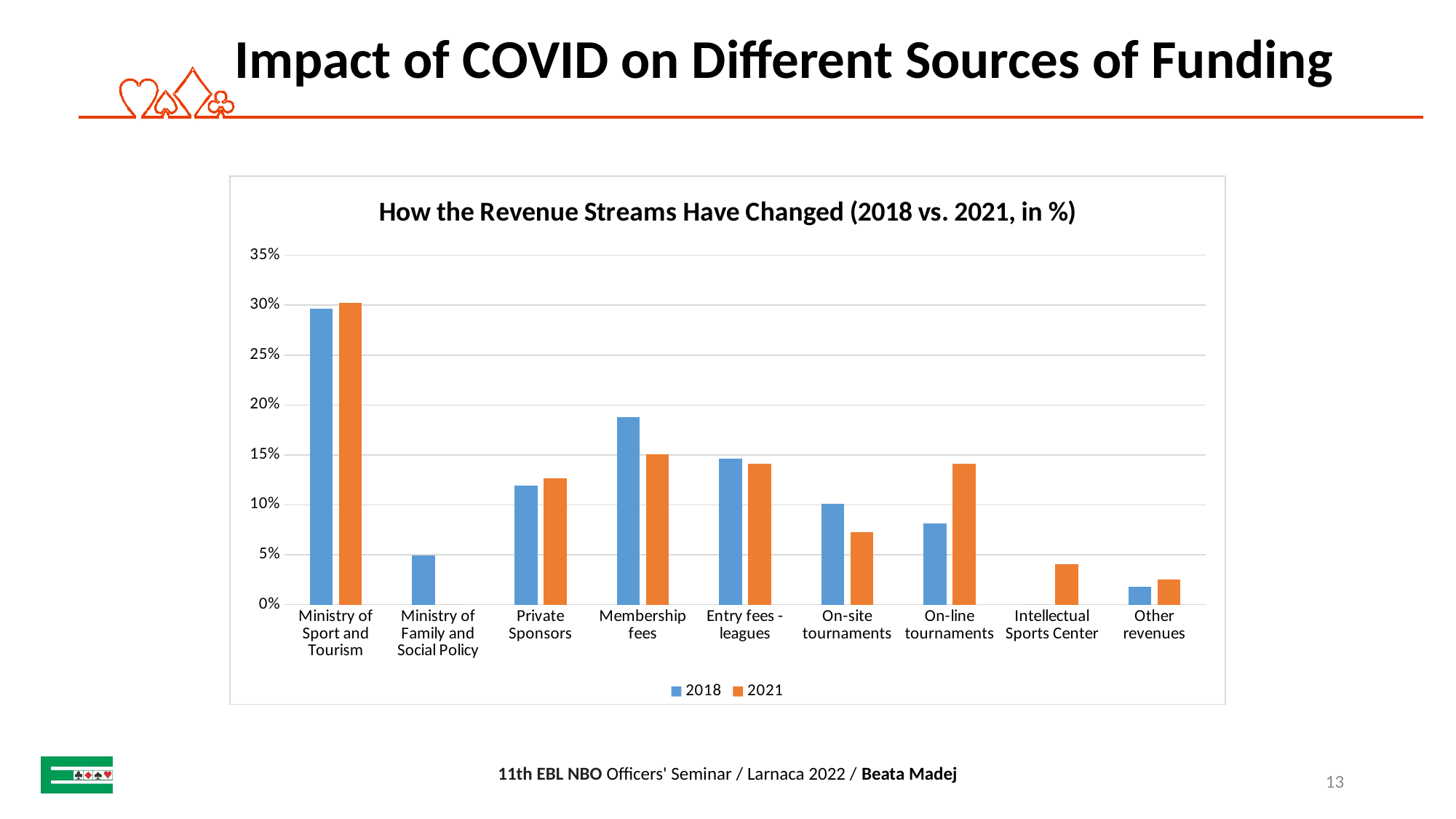
For On-line tournaments, which year has the larger value, 2018 or 2021? 2021 What type of chart is shown on the slide? bar chart Is the 2021 value for Ministry of Sport and Tourism greater or less than 25%? greater Is the 2021 value for On-site tournaments greater or less than 10%? less What is the title of the chart? How the Revenue Streams Have Changed (2018 vs. 2021, in %) How many series does the legend list? 2 For On-site tournaments, which year has the larger value, 2018 or 2021? 2018 Is the 2018 value for Membership fees greater or less than 15%? greater Which category has the highest value for 2018? Ministry of Sport and Tourism Which category has the highest value for 2021? Ministry of Sport and Tourism For Membership fees, which year has the larger value, 2018 or 2021? 2018 How many revenue stream categories are shown on the x axis? 9